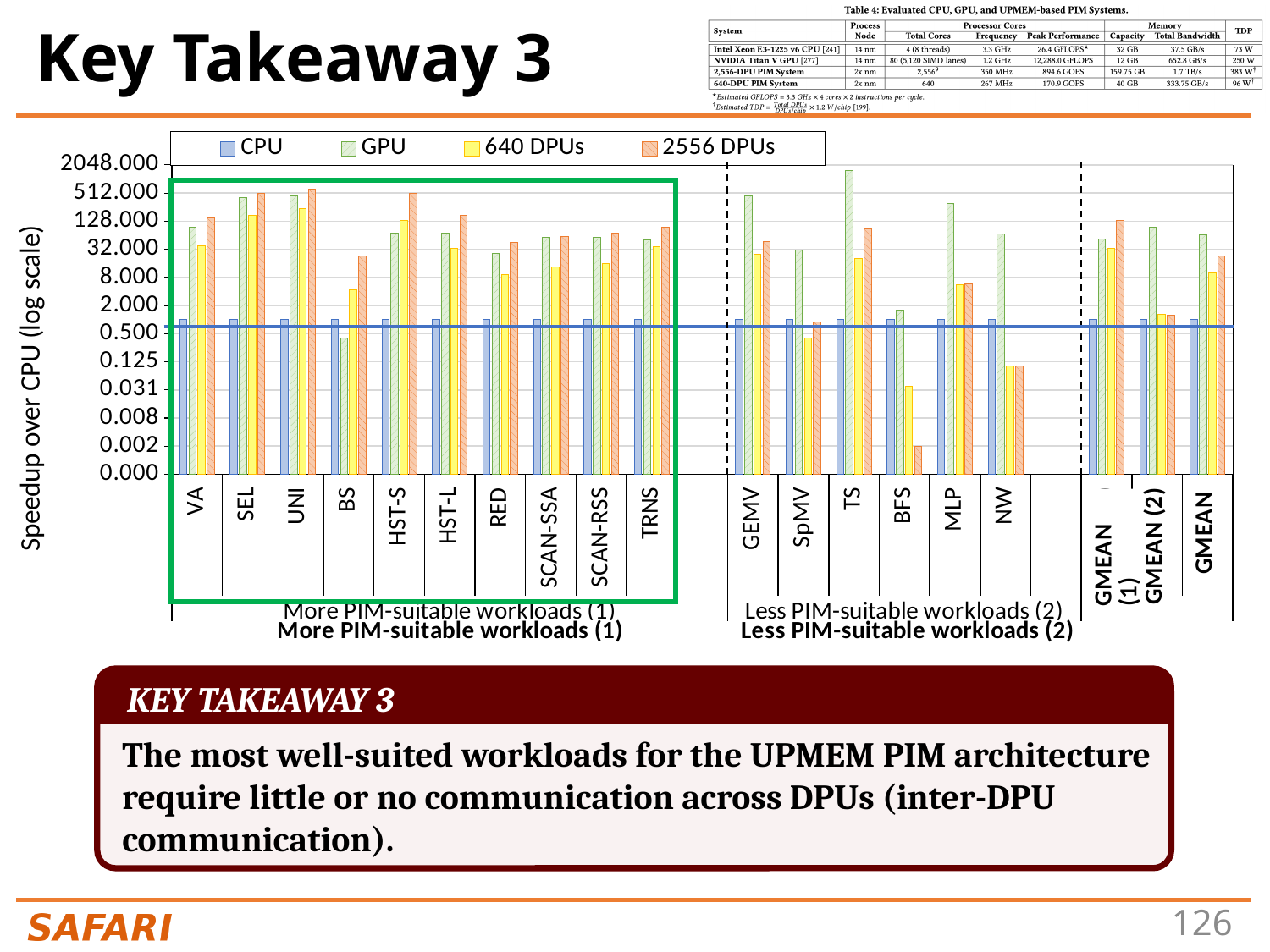
What kind of chart is shown on the slide? bar chart Which series in the legend is drawn in yellow? 640 DPUs For BS, which is larger: the GPU value or the 2556 DPUs value? 2556 DPUs Is the 640 DPUs value for NW greater or less than 0.5? less Is the 2556 DPUs value for UNI greater or less than 128? greater How many series does the chart legend list? 4 Is the 2556 DPUs value for BFS greater or less than 0.031? less What is the label of the y axis of the chart? Speedup over CPU (log scale) How many workload categories are plotted along the x axis of the chart? 19 Which workload has the lowest 2556 DPUs value? BFS For GEMV, which is larger: the GPU value or the 2556 DPUs value? GPU